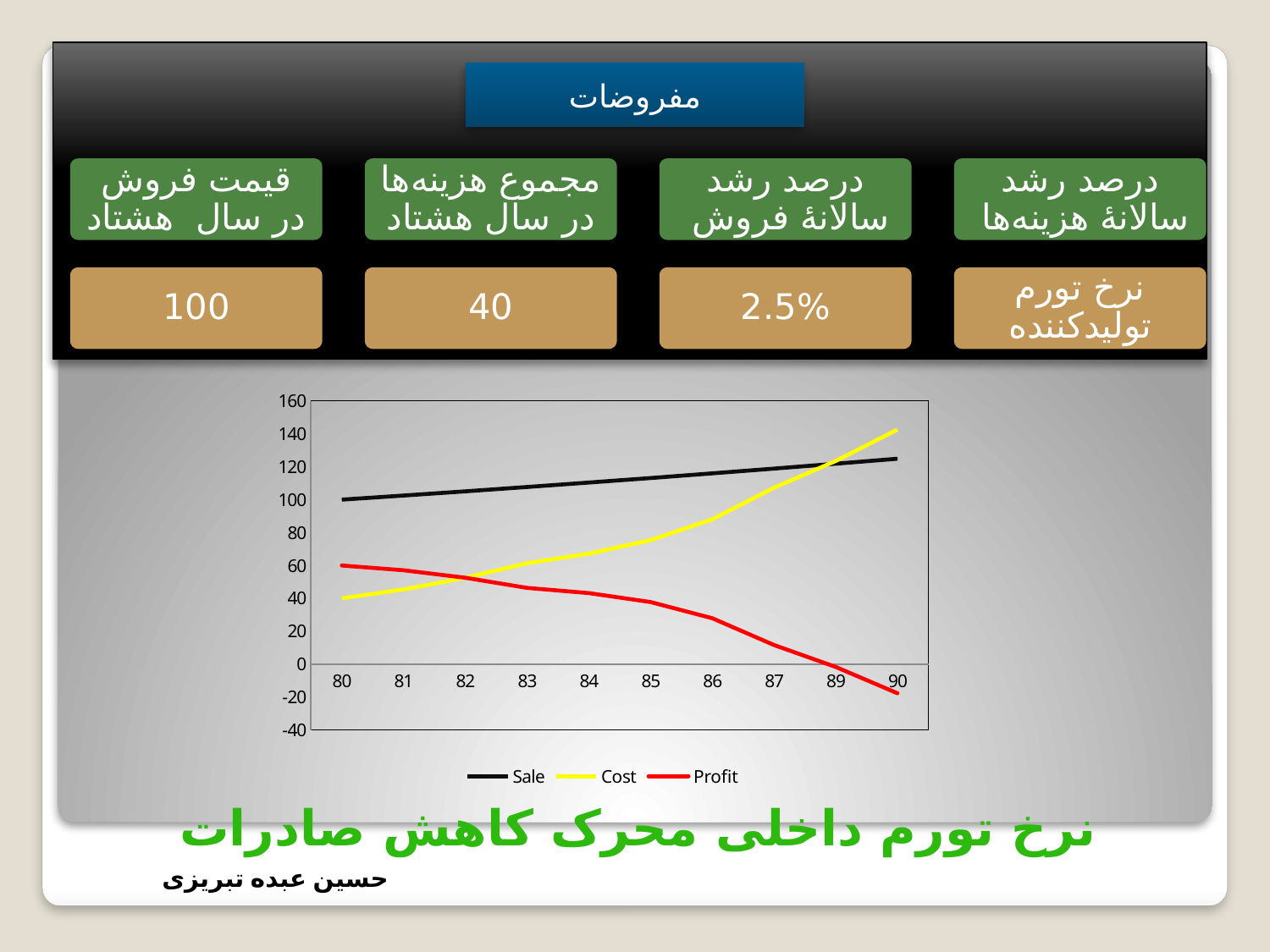
At 90, which is larger, Cost or Sale? Cost What is the value of Profit at 80? 60 Is the value for Profit at 90 greater or less than 0? less Does the Profit line rise or fall from 80 to 90? fall Does the Cost line rise or fall from 80 to 90? rise Is the value for Cost at 90 greater or less than 120? greater What is the value of Cost at 80? 40 What is the value of Sale at 80? 100 What is the difference between Sale and Cost at 80? 60 How many points are plotted along the x axis of the chart? 10 What kind of chart is shown on the slide? line chart How many series does the chart's legend list? 3